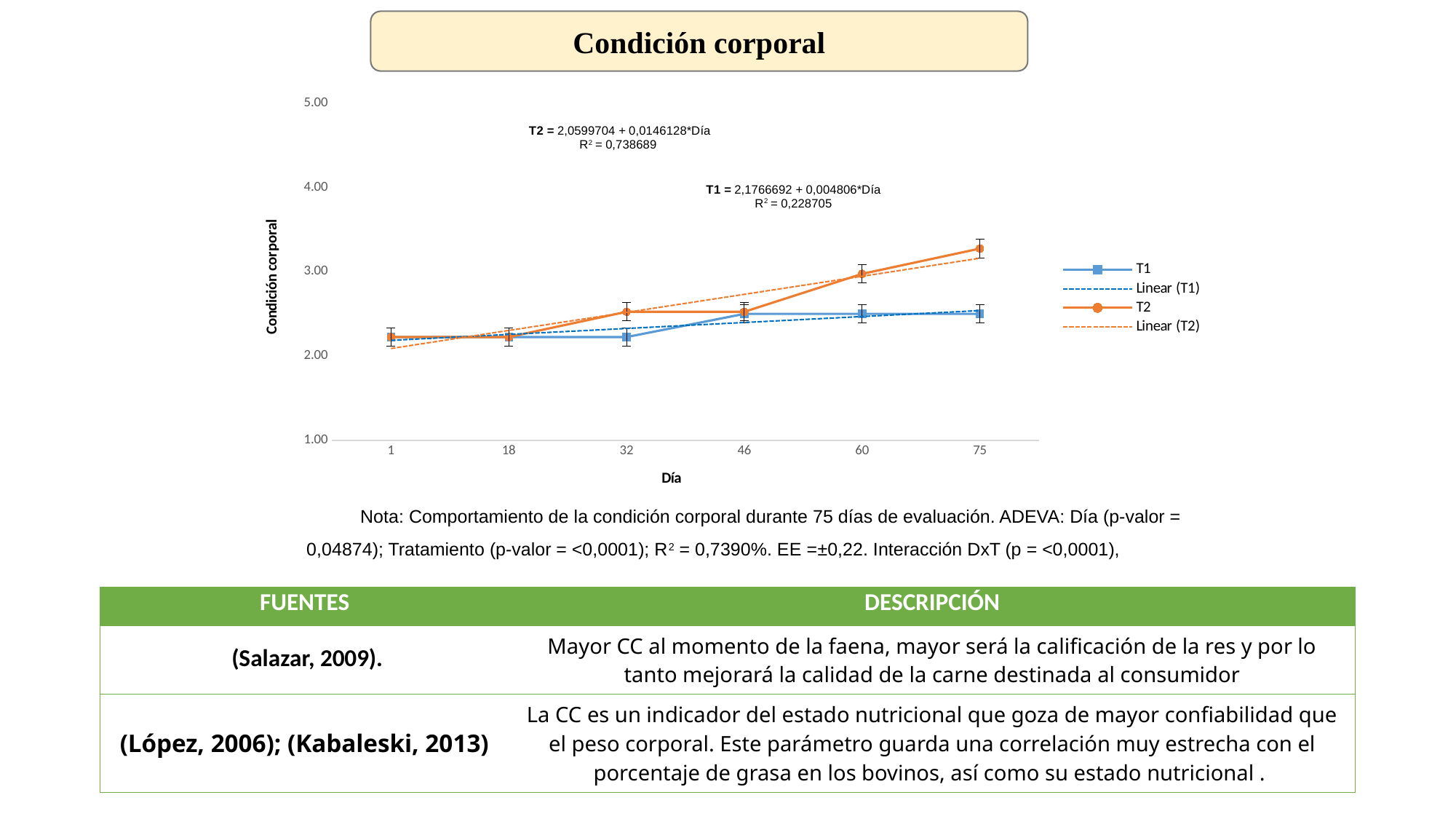
Does the T2 series rise or fall from day 1 to day 75? rises At day 75, which series has the higher value, T1 or T2? T2 What kind of chart is shown on the slide? line chart What is the label of the x axis of the chart? Día At which day does the T2 series reach its highest value? 75 How many entries does the chart legend list? 4 How many day values are marked along the x axis of the chart? 6 What is the title of the chart? Condición corporal Is the value for T2 at day 75 greater or less than 3.00? greater Is the value for T1 at day 32 greater or less than 2.00? greater At day 60, which series has the higher value, T1 or T2? T2 Is the value for T1 at day 75 greater or less than 3.00? less